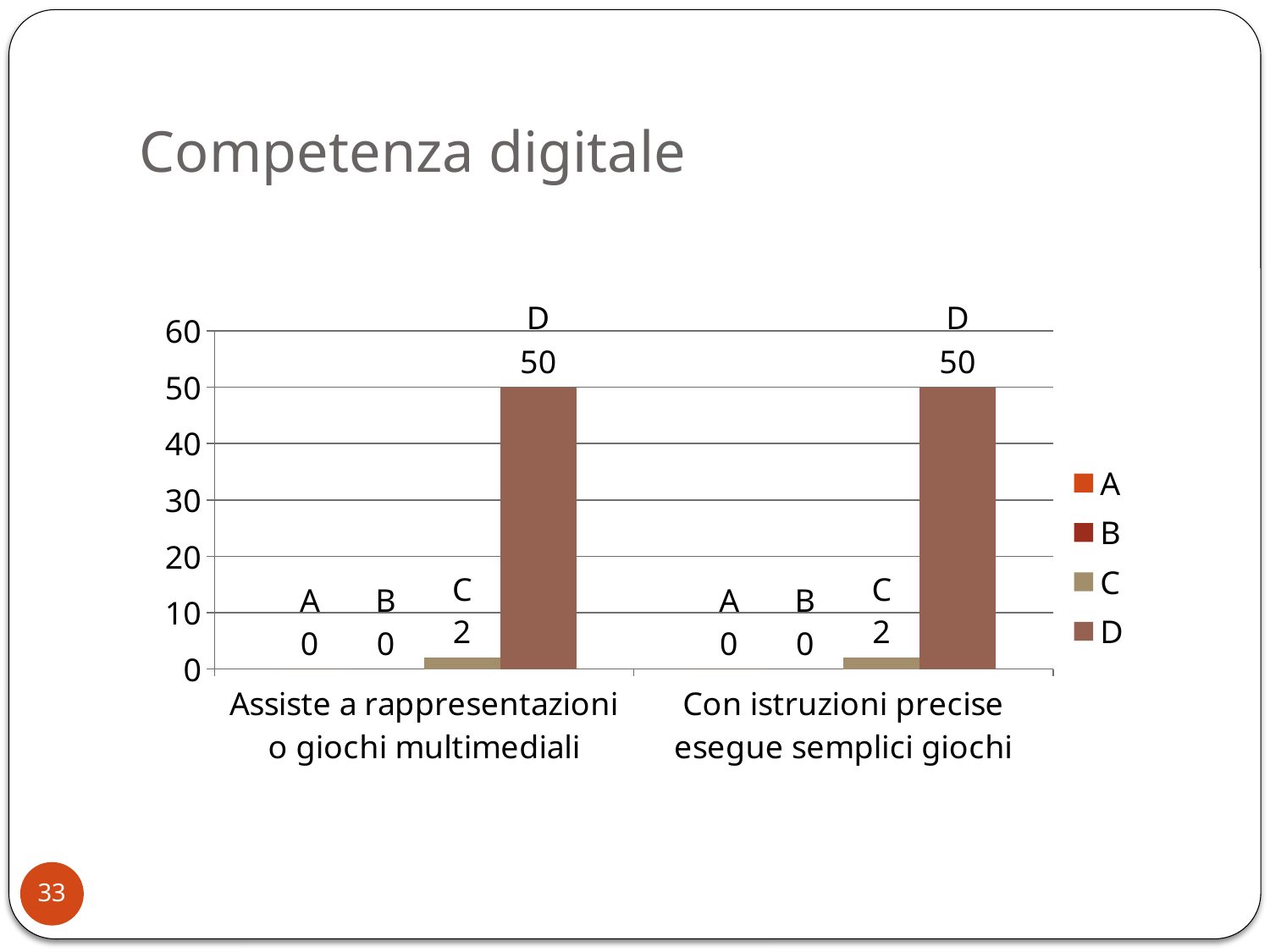
What is the value of series C for "Con istruzioni precise esegue semplici giochi"? 2 What kind of chart is shown on the slide? bar chart How many categories are shown on the x axis? 2 Which series has the highest value for "Con istruzioni precise esegue semplici giochi"? D What is the title of the slide containing the chart? Competenza digitale How many series does the legend list? 4 What is the value of series B for "Con istruzioni precise esegue semplici giochi"? 0 Which is larger for "Assiste a rappresentazioni o giochi multimediali": series C or series D? D Is the value of series D for "Con istruzioni precise esegue semplici giochi" greater or less than 40? greater What is the value of series A for "Assiste a rappresentazioni o giochi multimediali"? 0 What is the difference between series D and series C for "Assiste a rappresentazioni o giochi multimediali"? 48 What is the value of series D for "Assiste a rappresentazioni o giochi multimediali"? 50